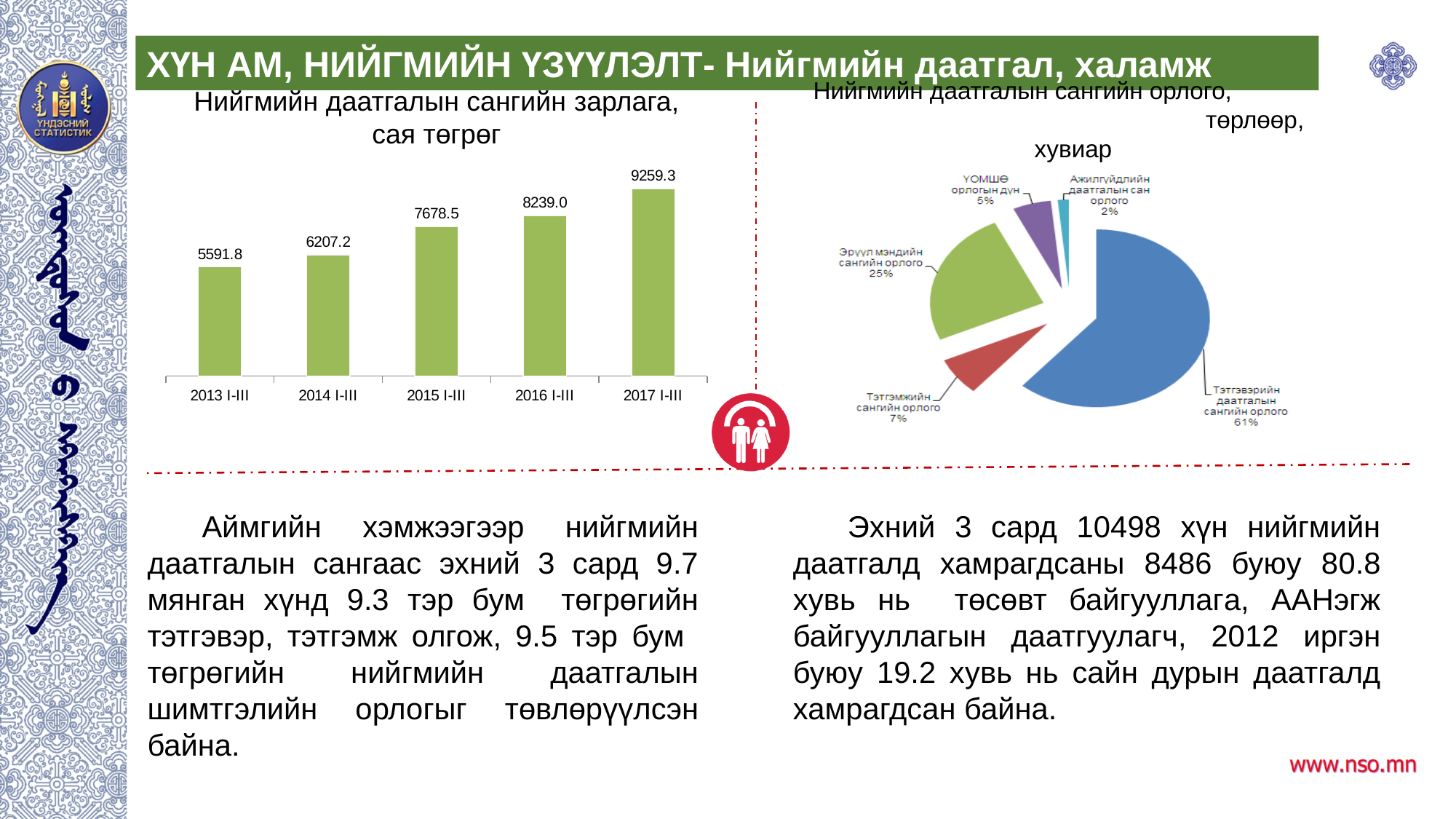
In the bar chart on the left, which period has the highest value? 2017 I-III What kind of chart is the chart on the left of the slide? bar chart In the bar chart on the left, how many periods are shown? 5 In the bar chart on the left, what is the value for 2013 I-III? 5591.8 In the pie chart on the right, which category has the smallest share? Ажилгүйдлийн даатгалын сан орлого In the pie chart on the right, what share does Эрүүл мэндийн сангийн орлого have? 25% In the pie chart on the right, what share does Тэтгэврийн даатгалын сангийн орлого have? 61% In the pie chart on the right, how many slices are there? 5 In the bar chart on the left, what is the difference between the values for 2016 I-III and 2015 I-III? 560.5 In the bar chart on the left, which period has the lowest value? 2013 I-III In the bar chart on the left, do the values rise or fall from 2013 I-III to 2017 I-III? rise In the bar chart on the left, what is the value for 2017 I-III? 9259.3